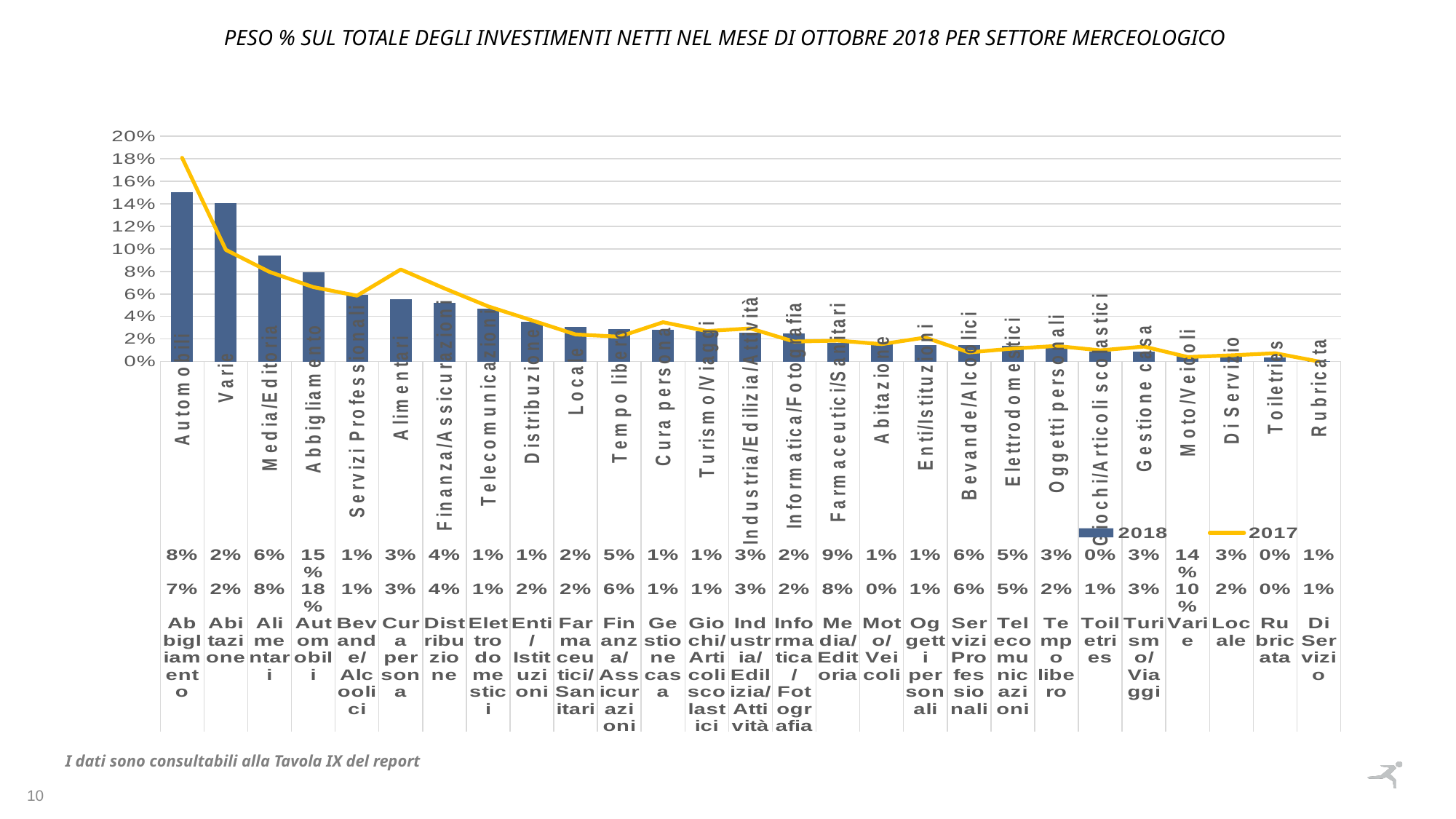
What is the 2017 value for Automobili? 18% Which sector has the highest 2018 value? Automobili How many sectors are plotted on the x axis? 27 How many series does the legend list? 2 What kind of chart is shown on the slide? Bar chart with a line overlay Do the 2018 bars rise or fall from left to right along the x axis? Fall What is the 2018 value for Varie? 14% Which two series are listed in the legend? 2018 and 2017 Which is larger for Varie: the 2018 value or the 2017 value? 2018 What is the 2018 value for Automobili? 15% What is the 2018 value for Media/Editoria? 9% What is the difference between the 2017 and 2018 values for Automobili? 3 percentage points